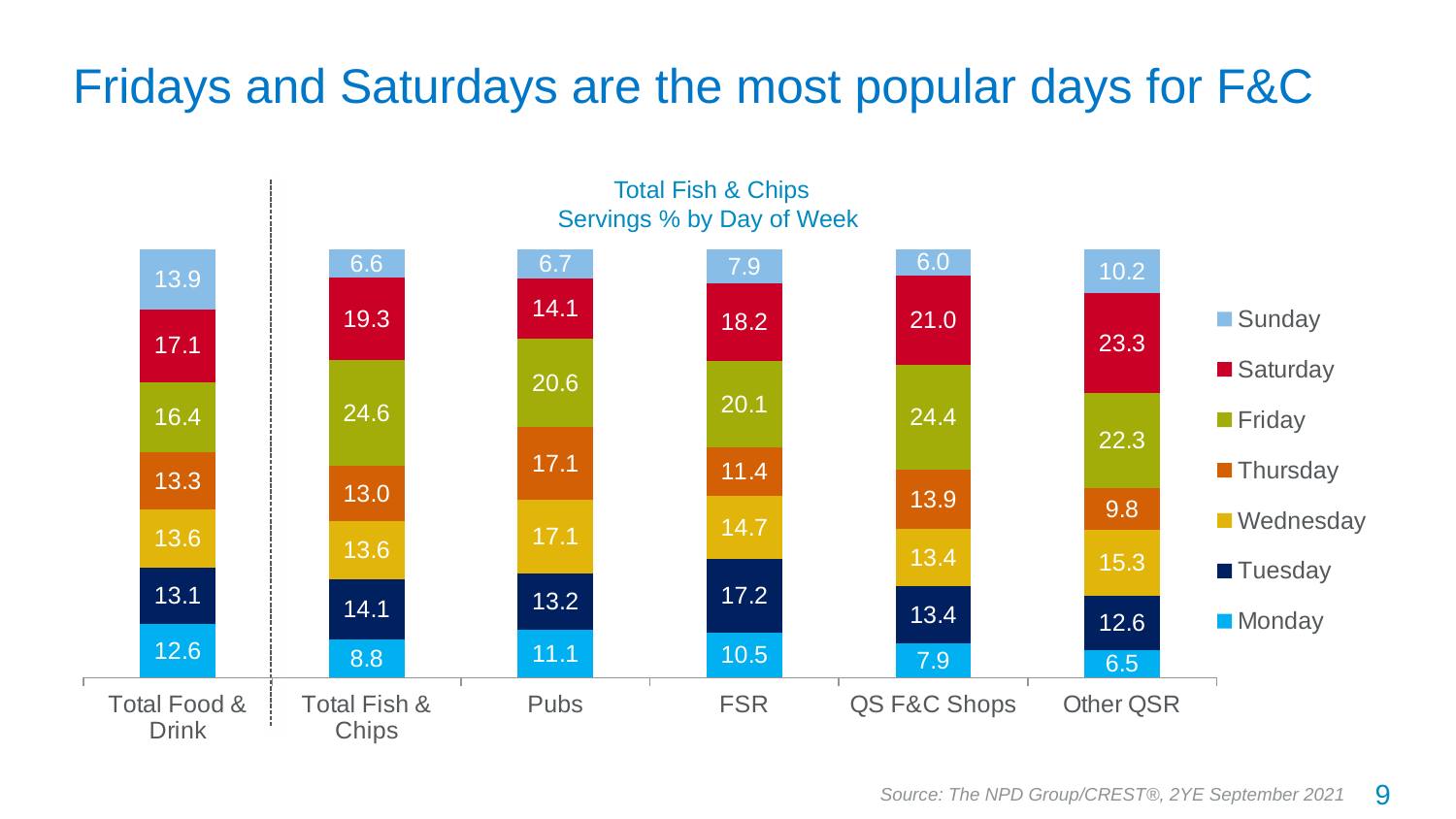
What is the title of the chart? Total Fish & Chips Servings % by Day of Week What kind of chart is shown on the slide? Stacked bar chart What is the Saturday value for Other QSR? 23.3 How many series does the legend list? 7 Which category has the lowest Monday value? Other QSR Which is larger for Pubs: the Friday value or the Saturday value? Friday What is the Friday value for Total Fish & Chips? 24.6 What is the Monday value for QS F&C Shops? 7.9 Which category has the highest Friday value? Total Fish & Chips How many categories are shown along the x axis? 6 What is the difference between the Saturday and Sunday values for QS F&C Shops? 15.0 What is the total of the stacked bar for FSR? 100.0